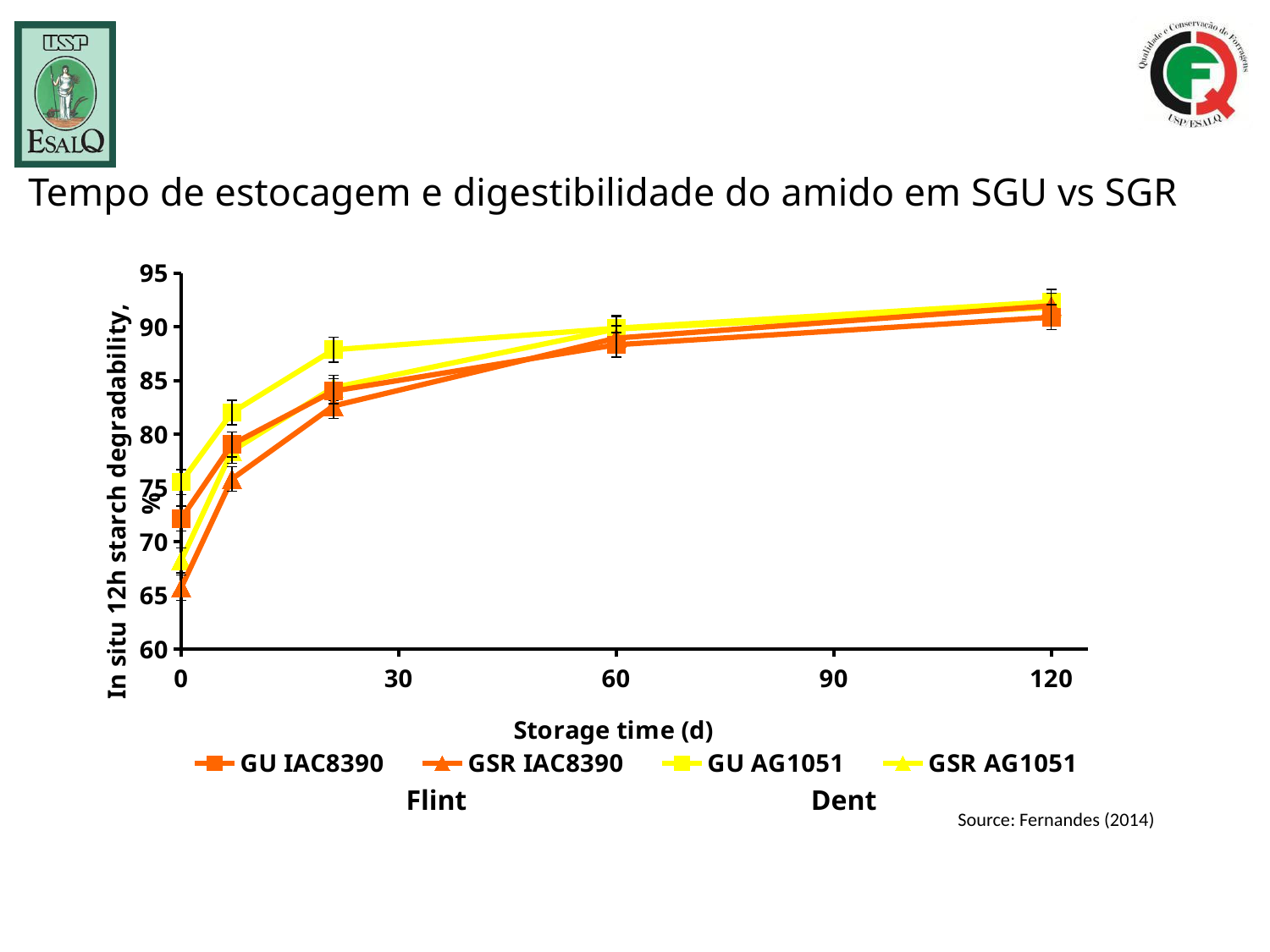
Which series has the highest value at storage time 0? GU AG1051 What kind of chart is shown on the slide? line chart Which two legend entries are grouped under the label Dent? GU AG1051 and GSR AG1051 Is the value for GSR IAC8390 at storage time 0 greater or less than 70? less Is the value for GU IAC8390 at storage time 120 greater or less than 85? greater How many series does the legend list? 4 How many storage time points are plotted for each series? 5 At storage time 0, which is larger: GU AG1051 or GSR IAC8390? GU AG1051 Is the value for GU AG1051 at storage time 0 greater or less than 70? greater Which series has the lowest value at storage time 0? GSR IAC8390 Do the values for GSR IAC8390 rise or fall as storage time increases? rise What is the label of the x axis? Storage time (d)